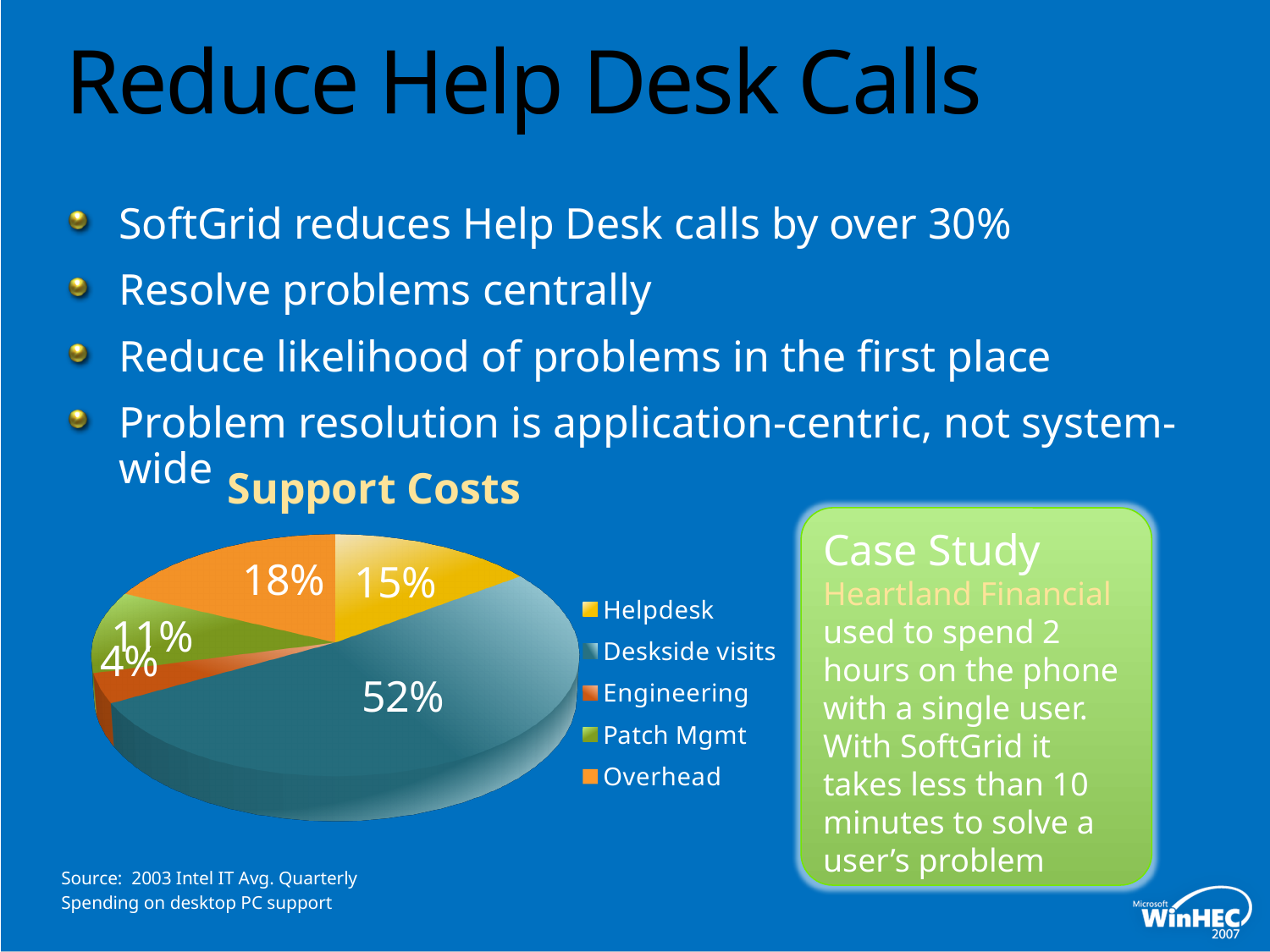
What share of support costs is attributed to Deskside visits? 52% Which category accounts for the largest share of support costs? Deskside visits Which is larger, the Overhead share or the Helpdesk share? Overhead How many categories does the Support Costs pie chart show? 5 What share of support costs is attributed to Engineering? 4% Which category accounts for the smallest share of support costs? Engineering What is the title of the pie chart? Support Costs What share of support costs is attributed to Overhead? 18% How many percentage points larger is the Deskside visits share than the Overhead share? 34 What share of support costs is attributed to Helpdesk? 15% What kind of chart is shown under the title "Support Costs"? pie chart What share of support costs is attributed to Patch Mgmt? 11%